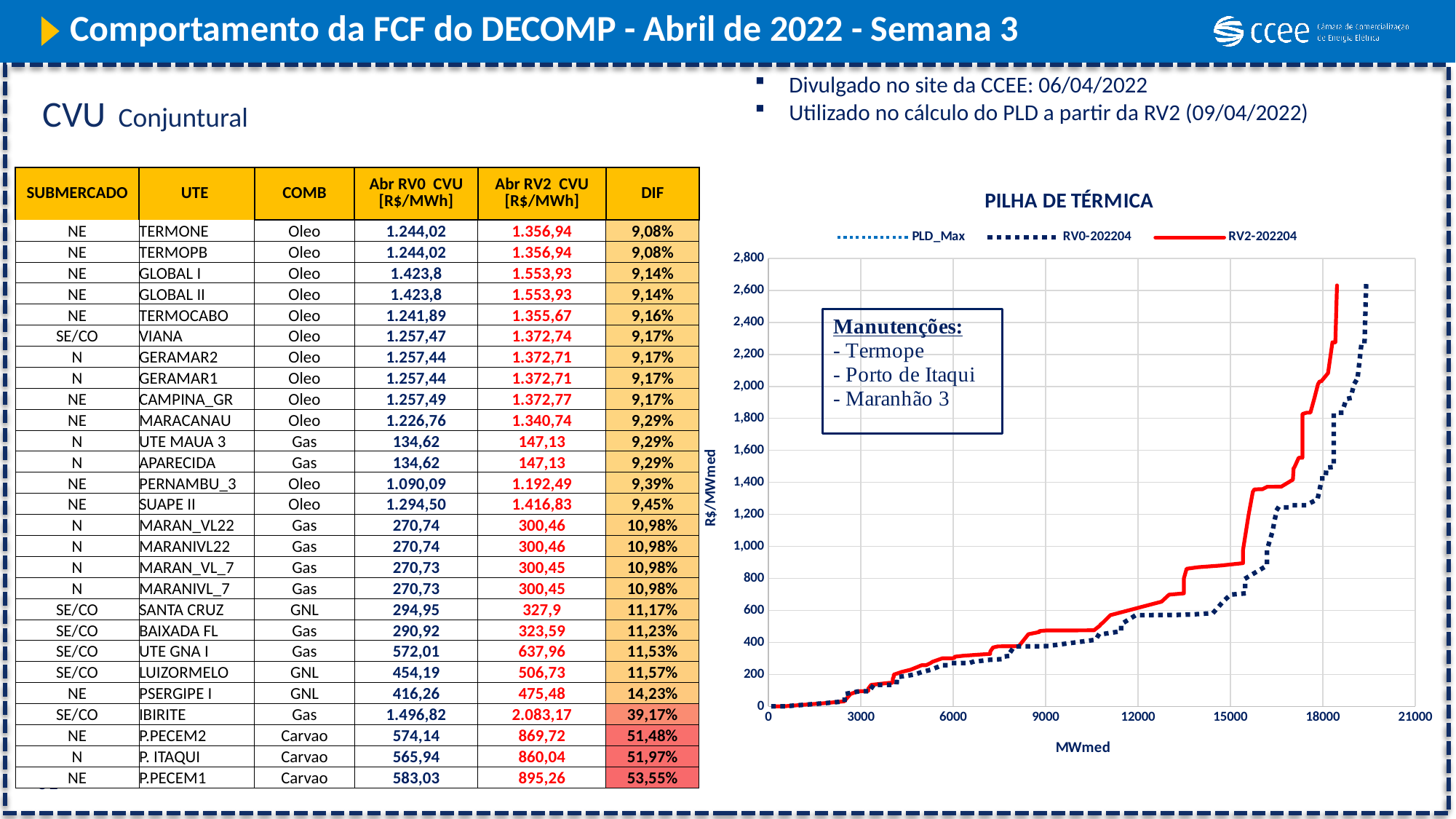
In the "PILHA DE TÉRMICA" chart, do the RV2-202204 values rise or fall as MWmed increases? rise In the "PILHA DE TÉRMICA" chart, is the RV2-202204 value at 12000 MWmed greater or less than 400? greater In the "PILHA DE TÉRMICA" chart, at 12000 MWmed, which series has the higher value, RV0-202204 or RV2-202204? RV2-202204 How many series does the legend of the "PILHA DE TÉRMICA" chart list? 3 In the "PILHA DE TÉRMICA" chart, which series is drawn as a solid red line? RV2-202204 What type of chart is "PILHA DE TÉRMICA"? line chart What is the title of the chart on the right side of the slide? PILHA DE TÉRMICA In the "PILHA DE TÉRMICA" chart, is the RV0-202204 value at 3000 MWmed greater or less than 400? less In the "PILHA DE TÉRMICA" chart, at 15000 MWmed, which series has the higher value, RV0-202204 or RV2-202204? RV2-202204 In the "PILHA DE TÉRMICA" chart, is the RV0-202204 value at 9000 MWmed greater or less than 600? less